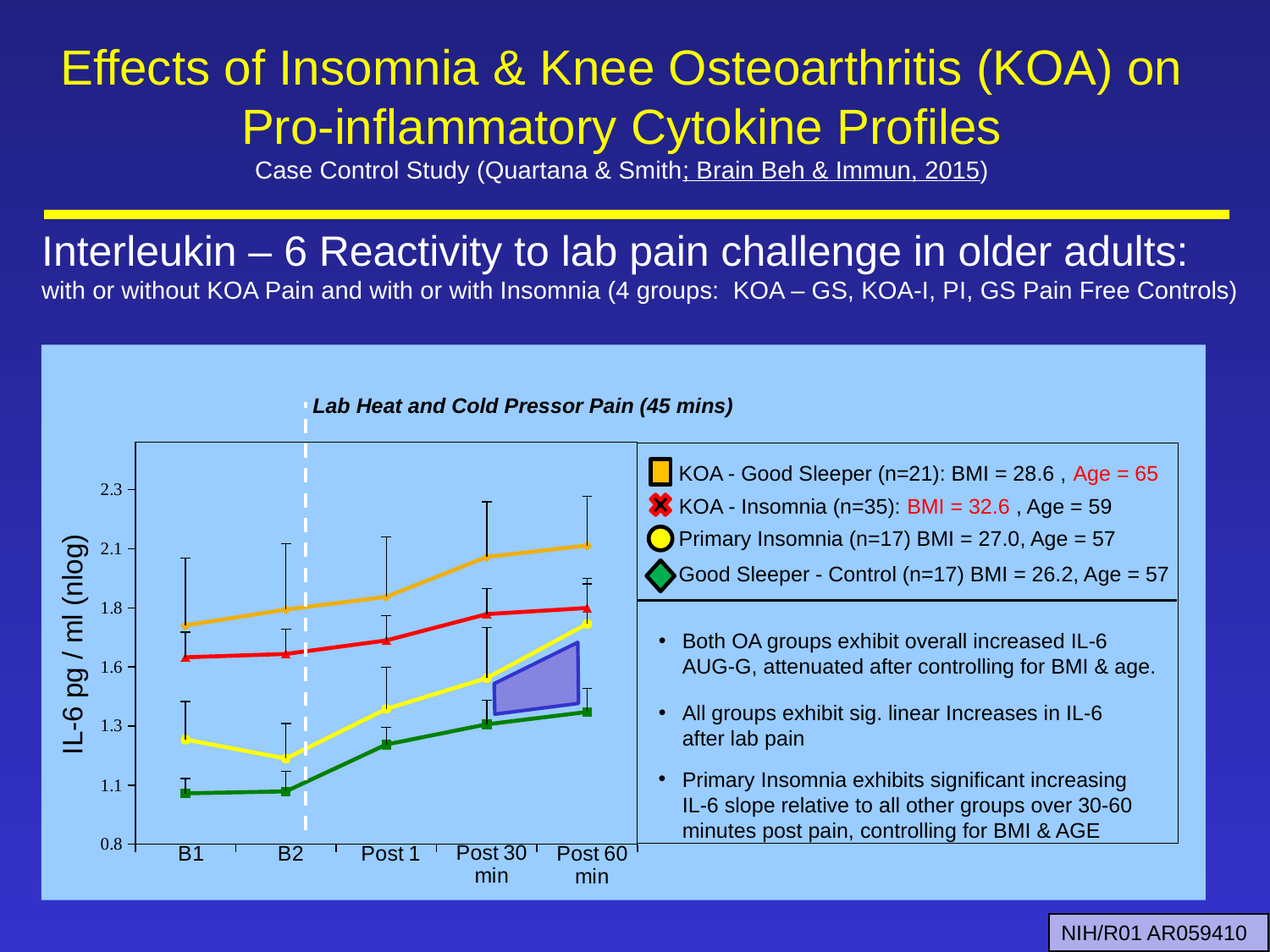
At Post 60 min, which is larger: the value for KOA - Good Sleeper or for KOA - Insomnia? KOA - Good Sleeper Which group has the lowest IL-6 value at B1? Good Sleeper - Control How many series does the legend list? 4 How many time points are plotted along the x axis? 5 At Post 30 min, which is larger: the value for KOA - Insomnia or for Primary Insomnia? KOA - Insomnia Is the value for KOA - Good Sleeper at Post 60 min greater or less than 1.8? greater Do the IL-6 values for the Good Sleeper - Control group rise or fall from B1 to Post 60 min? rise Which group has the highest IL-6 value at Post 60 min? KOA - Good Sleeper Is the value for Primary Insomnia at B2 greater or less than 1.3? less What kind of chart is shown on the slide? line chart Is the value for KOA - Insomnia at Post 60 min greater or less than 2.1? less What is the label on the y axis of the chart? IL-6 pg / ml (nlog)